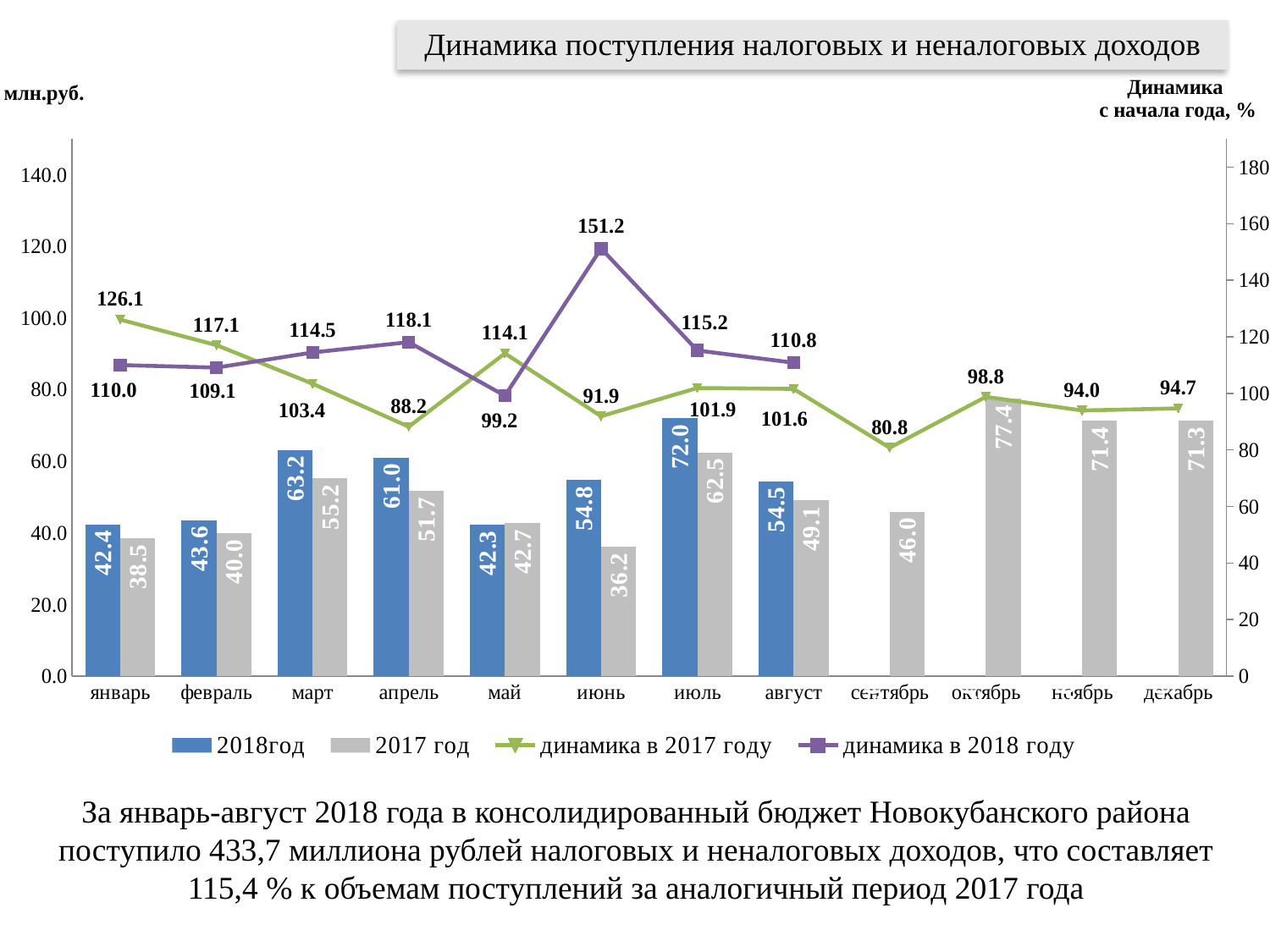
What is the value of the 2018год series for июль? 72.0 Which month has the lowest 2017 год bar? июнь What is the difference between динамика в 2018 году and динамика в 2017 году for апрель? 29.9 What kind of chart is this? Combined bar and line chart Which month has the highest 2018год bar? июль What is the value of the 2017 год series for октябрь? 77.4 How many months are shown on the x axis? 12 What is the value of динамика в 2018 году for июнь? 151.2 What is the difference between the 2018год and 2017 год values for июль? 9.5 How many series does the legend list? 4 Which month has the lowest value of динамика в 2017 году? сентябрь For май, which is larger: the 2018год value or the 2017 год value? 2017 год